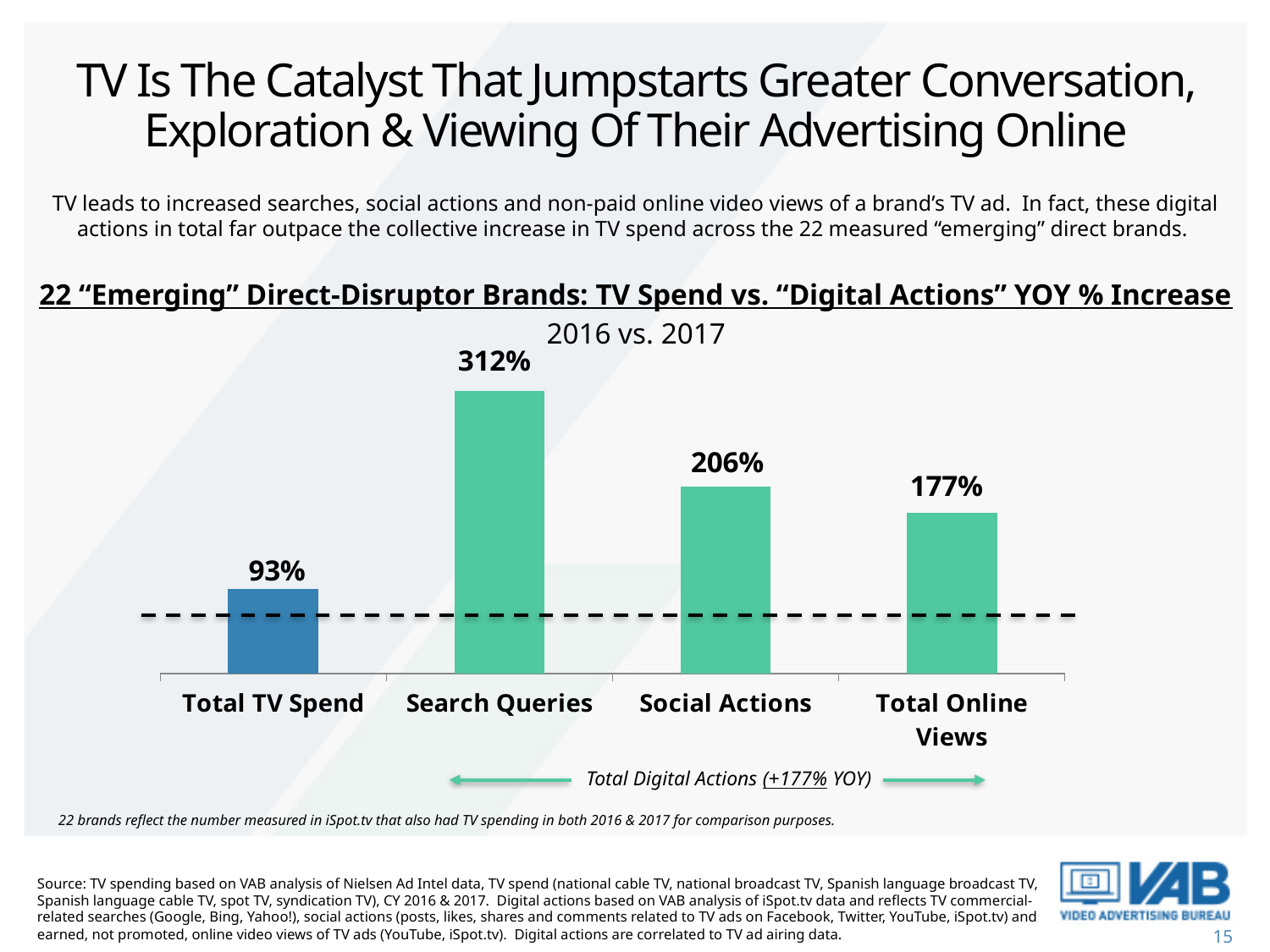
Which category has the highest YOY % increase? Search Queries How many categories are shown in the chart? 4 What kind of chart is shown on the slide? Bar chart What is the YOY % increase for Total TV Spend? 93% Which category has the lowest YOY % increase? Total TV Spend What is the YOY % increase for Search Queries? 312% What is the difference between the YOY % increase for Search Queries and Total TV Spend? 219% What years does the chart compare, according to its subtitle? 2016 vs. 2017 What is the YOY % increase for Social Actions? 206% Which is larger, the YOY % increase for Social Actions or for Total Online Views? Social Actions What is the difference between the YOY % increase for Social Actions and Total Online Views? 29% What is the YOY % increase for Total Online Views? 177%